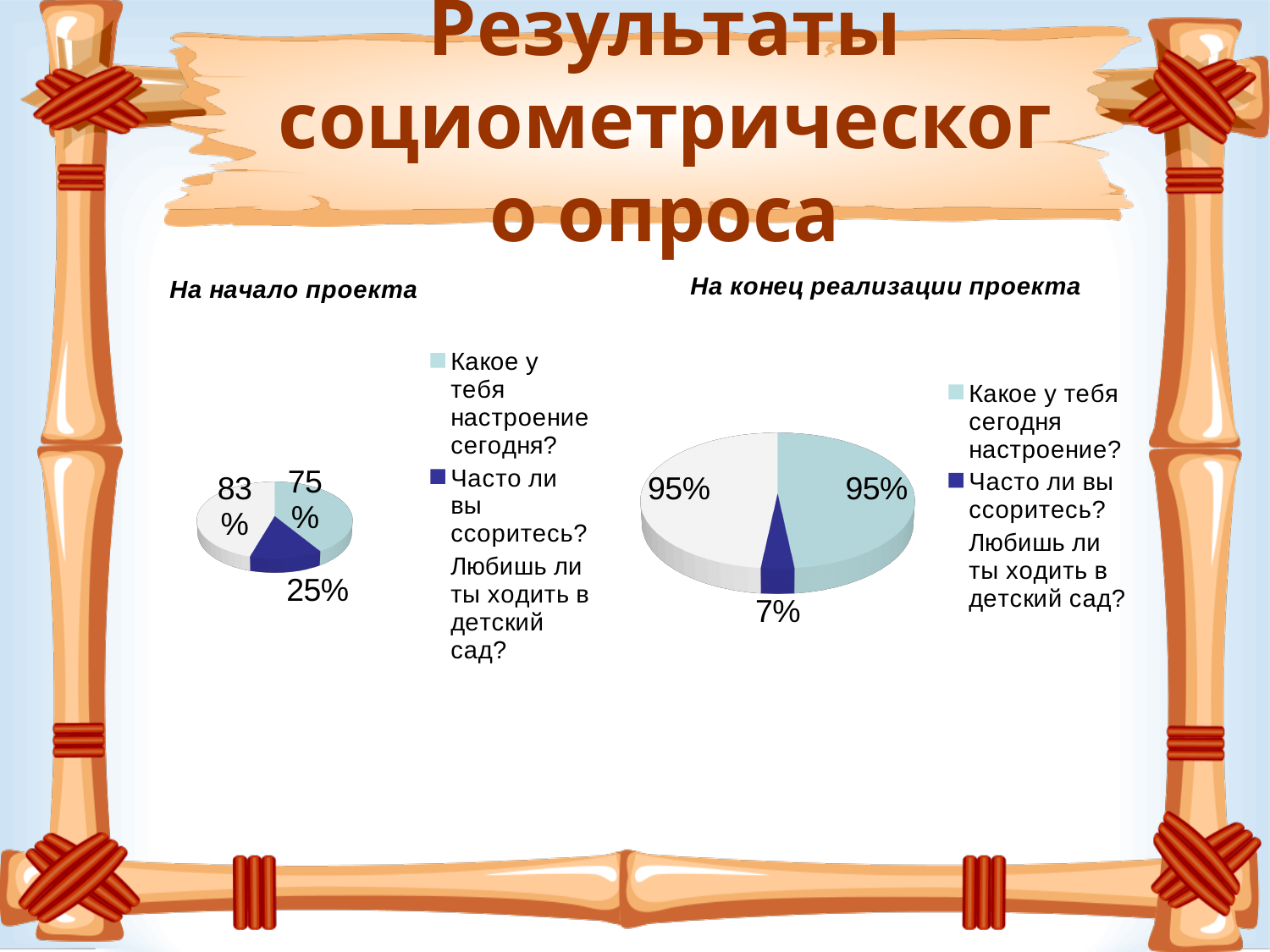
In the "На начало проекта" chart, what value is shown for "Какое у тебя настроение сегодня?"? 75% How many entries does the legend of the "На начало проекта" chart list? 3 In the "На начало проекта" chart, which category has the smallest value? Часто ли вы ссоритесь? In the "На начало проекта" chart, which category has the largest value? Любишь ли ты ходить в детский сад? In the "На конец реализации проекта" chart, what value is shown for "Какое у тебя сегодня настроение?"? 95% Which is larger: the value for "Часто ли вы ссоритесь?" in the "На начало проекта" chart or in the "На конец реализации проекта" chart? На начало проекта How many slices does the "На конец реализации проекта" pie chart have? 3 In the "На конец реализации проекта" chart, which category has the smallest value? Часто ли вы ссоритесь? In the "На начало проекта" chart, what value is shown for "Любишь ли ты ходить в детский сад?"? 83% In the "На начало проекта" chart, what value is shown for "Часто ли вы ссоритесь?"? 25% In the "На конец реализации проекта" chart, what value is shown for "Часто ли вы ссоритесь?"? 7% What kind of chart is shown under "На начало проекта"? Pie chart